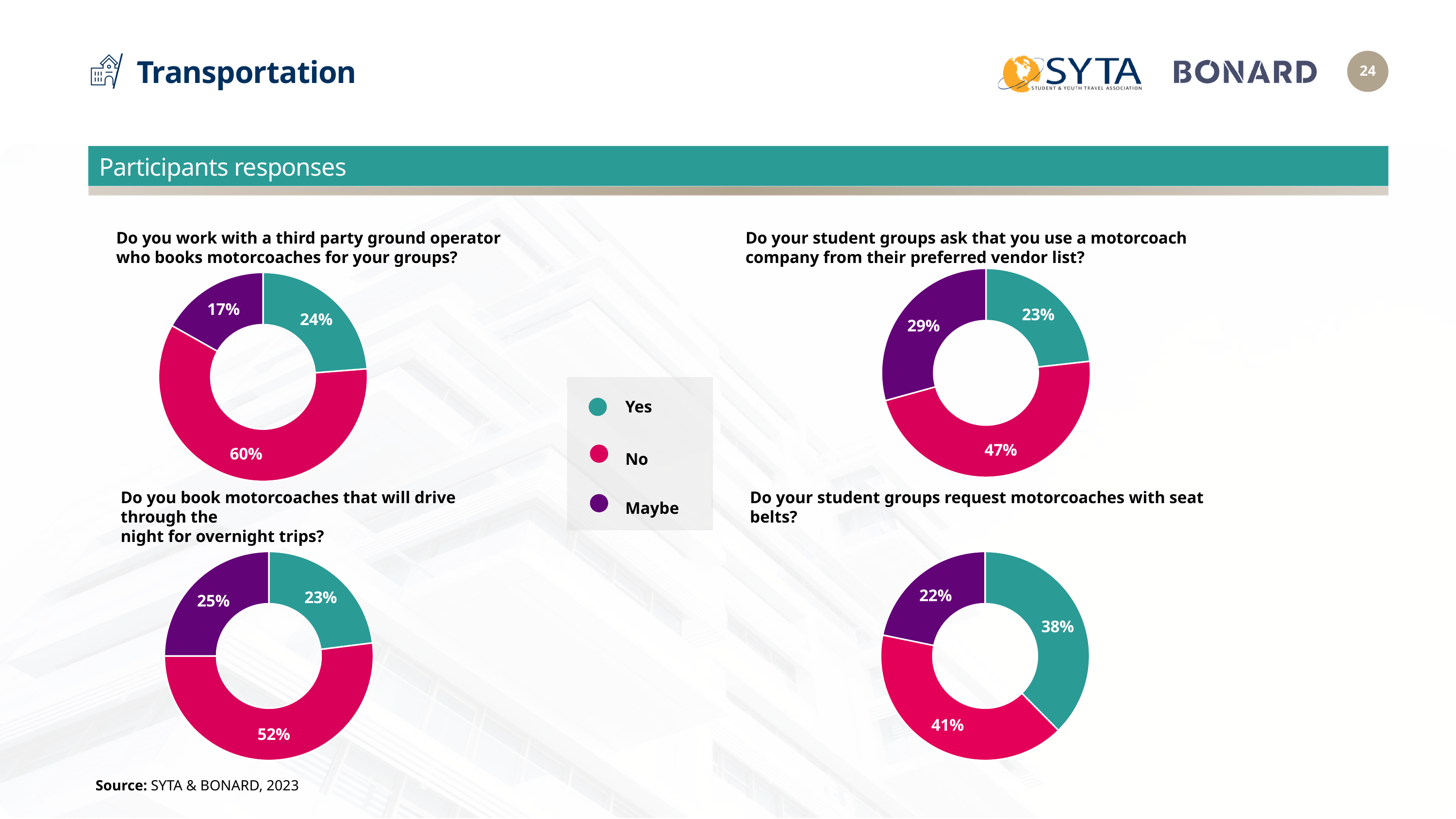
In the chart 'Do you book motorcoaches that will drive through the night for overnight trips?', which response has the smallest share? Yes How many response categories does the legend list? 3 What kind of chart is used for the four questions on the slide? Doughnut chart In the chart 'Do your student groups request motorcoaches with seat belts?', what share answered Yes? 38% In the chart 'Do you work with a third party ground operator who books motorcoaches for your groups?', what share answered Maybe? 17% In the chart 'Do you work with a third party ground operator who books motorcoaches for your groups?', what share of respondents answered No? 60% In the chart 'Do your student groups request motorcoaches with seat belts?', what is the difference between the No and Maybe shares? 19% In the chart 'Do you book motorcoaches that will drive through the night for overnight trips?', what share answered Maybe? 25% In the chart 'Do your student groups request motorcoaches with seat belts?', which is larger, the Yes share or the No share? No In the chart 'Do your student groups ask that you use a motorcoach company from their preferred vendor list?', what share answered Yes? 23% In the chart 'Do your student groups ask that you use a motorcoach company from their preferred vendor list?', which response has the largest share? No In the chart 'Do you work with a third party ground operator who books motorcoaches for your groups?', what is the difference between the No and Yes shares? 36%